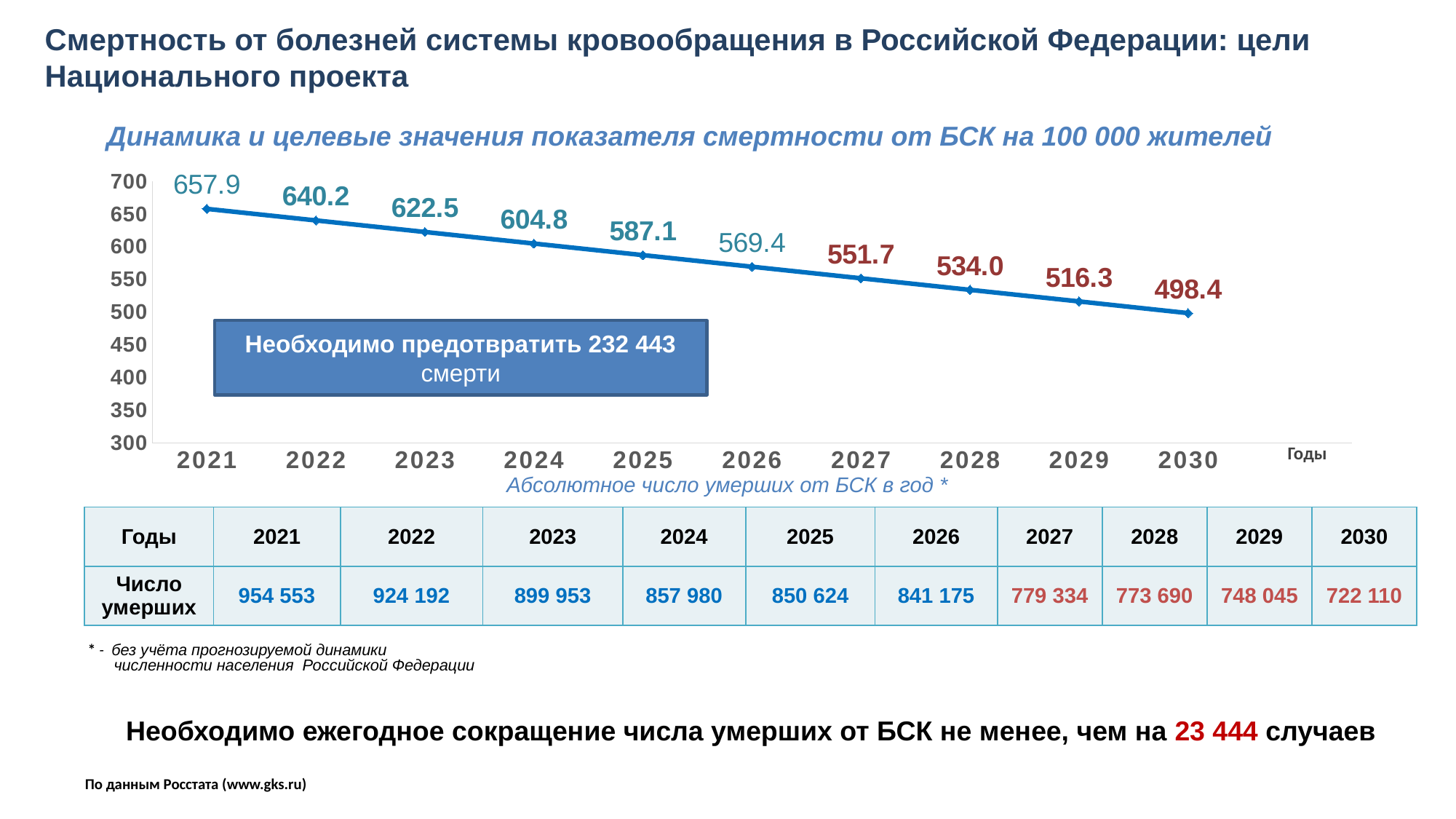
Which year has the highest value on the chart? 2021 What is the difference between the values for 2022 and 2023? 17.7 What is the value of the mortality indicator for 2030? 498.4 Do the values rise or fall from 2021 to 2030? Fall Is the value for 2026 greater or less than 550? greater What is the difference between the values for 2021 and 2030? 159.5 How many years (data points) are plotted on the chart? 10 What is the value of the mortality indicator for 2021? 657.9 Which is larger, the value for 2024 or the value for 2027? 2024 Which year has the lowest value on the chart? 2030 What type of chart is shown on the slide? Line chart What is the value of the mortality indicator for 2025? 587.1